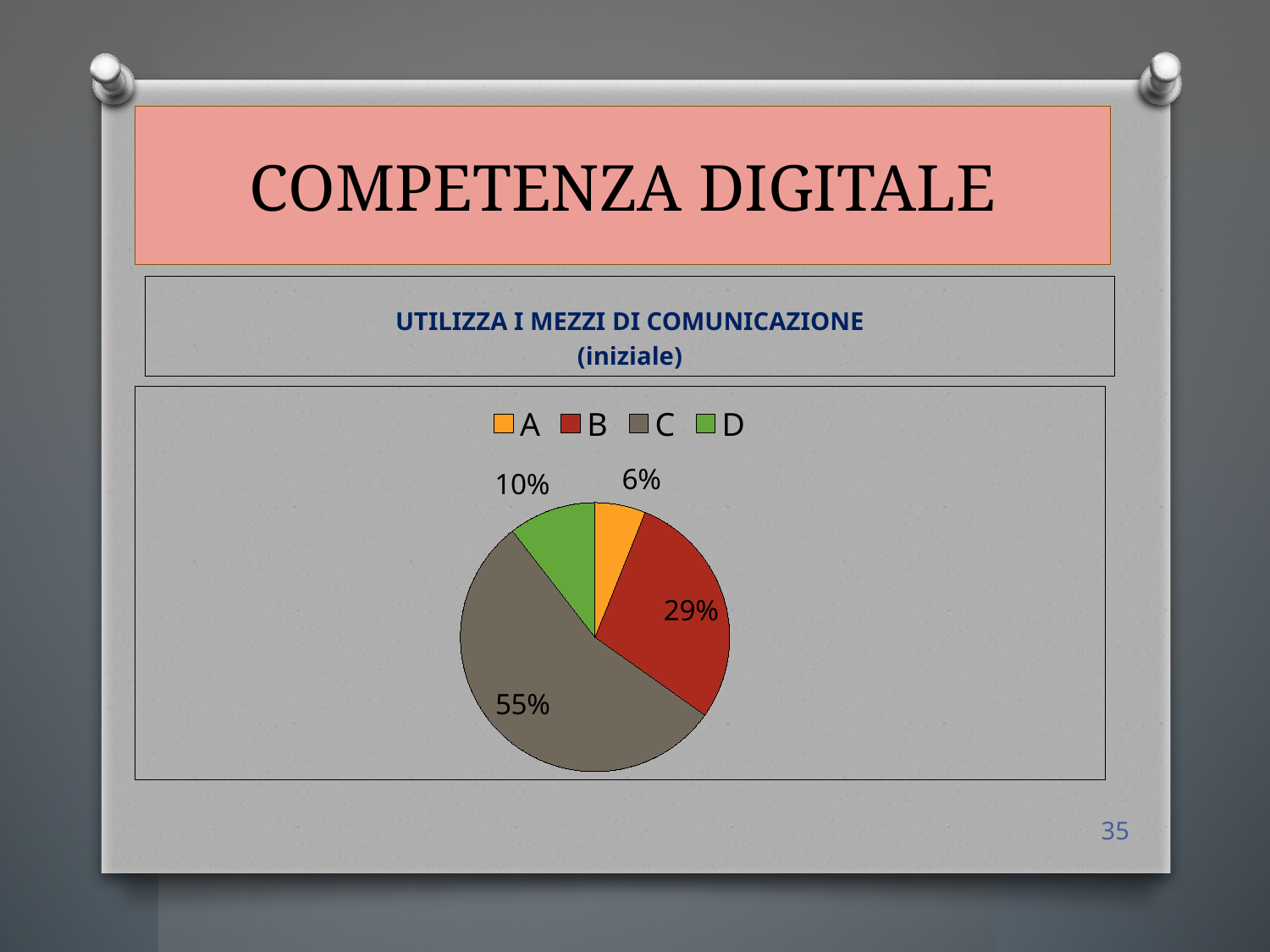
What share of the pie does category C have? 55% What share of the pie does category D have? 10% What share of the pie does category B have? 29% Which category has the largest slice of the pie? C What is the difference between the shares of C and B? 26% Which is larger, the share of D or the share of A? D What colour is the slice for category B? red How many categories does the legend list? 4 What kind of chart is shown on the slide? pie chart What is the title of the chart? UTILIZZA I MEZZI DI COMUNICAZIONE (iniziale) Which category has the smallest slice of the pie? A